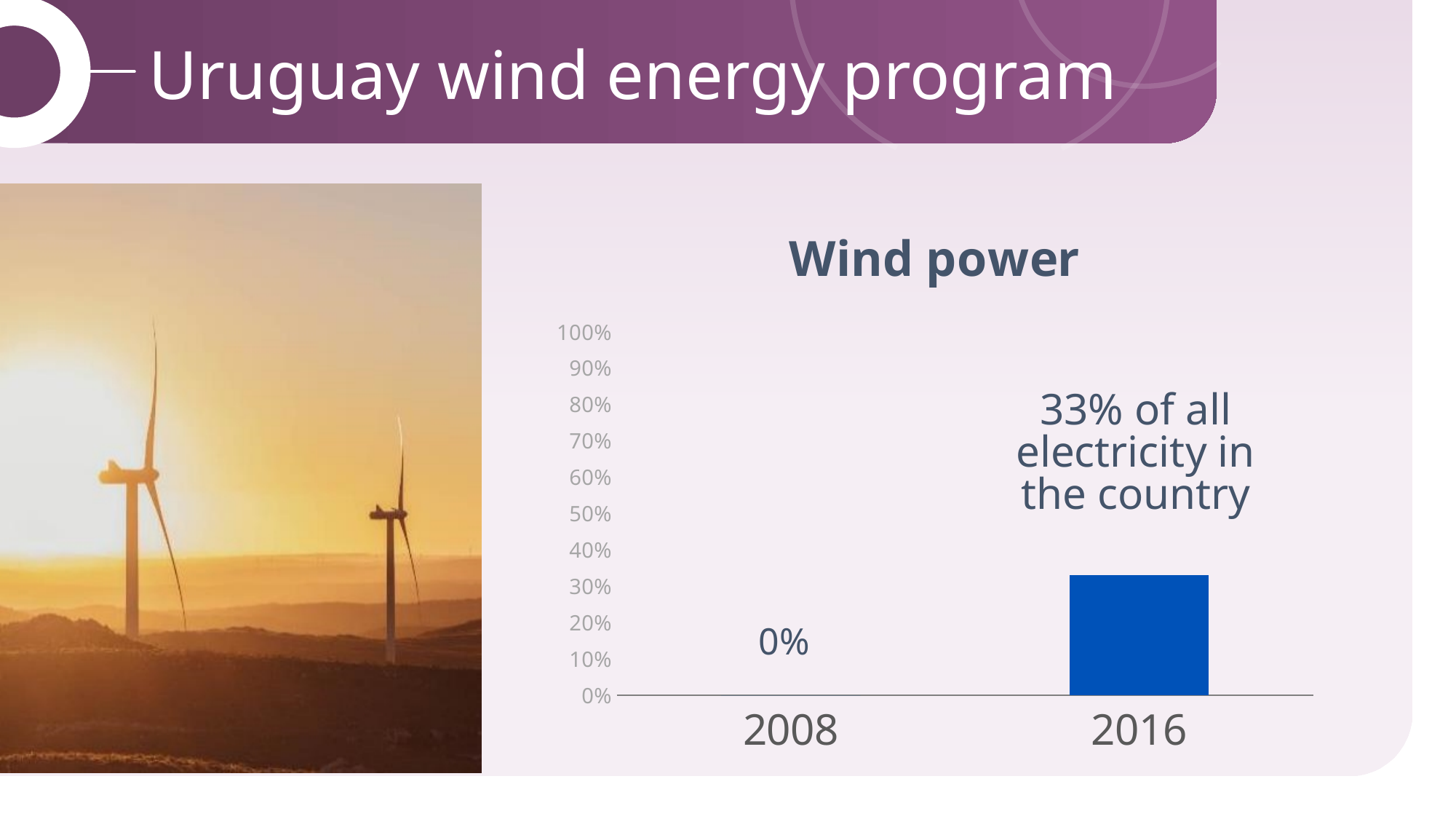
Is the value for 2016 in the Wind power chart greater or less than 40%? less What is the title of the chart on the slide? Wind power What is the value for 2008 in the Wind power chart? 0% Which year has the highest value in the Wind power chart? 2016 Which is larger in the Wind power chart, the value for 2008 or the value for 2016? 2016 How many years are shown on the x axis of the Wind power chart? 2 Which year has the lowest value in the Wind power chart? 2008 What kind of chart is the Wind power chart? bar chart Do the values in the Wind power chart rise or fall from 2008 to 2016? rise Is the value for 2016 in the Wind power chart greater or less than 20%? greater What is the difference between the 2016 and 2008 values in the Wind power chart? 33% What is the value for 2016 in the Wind power chart? 33%